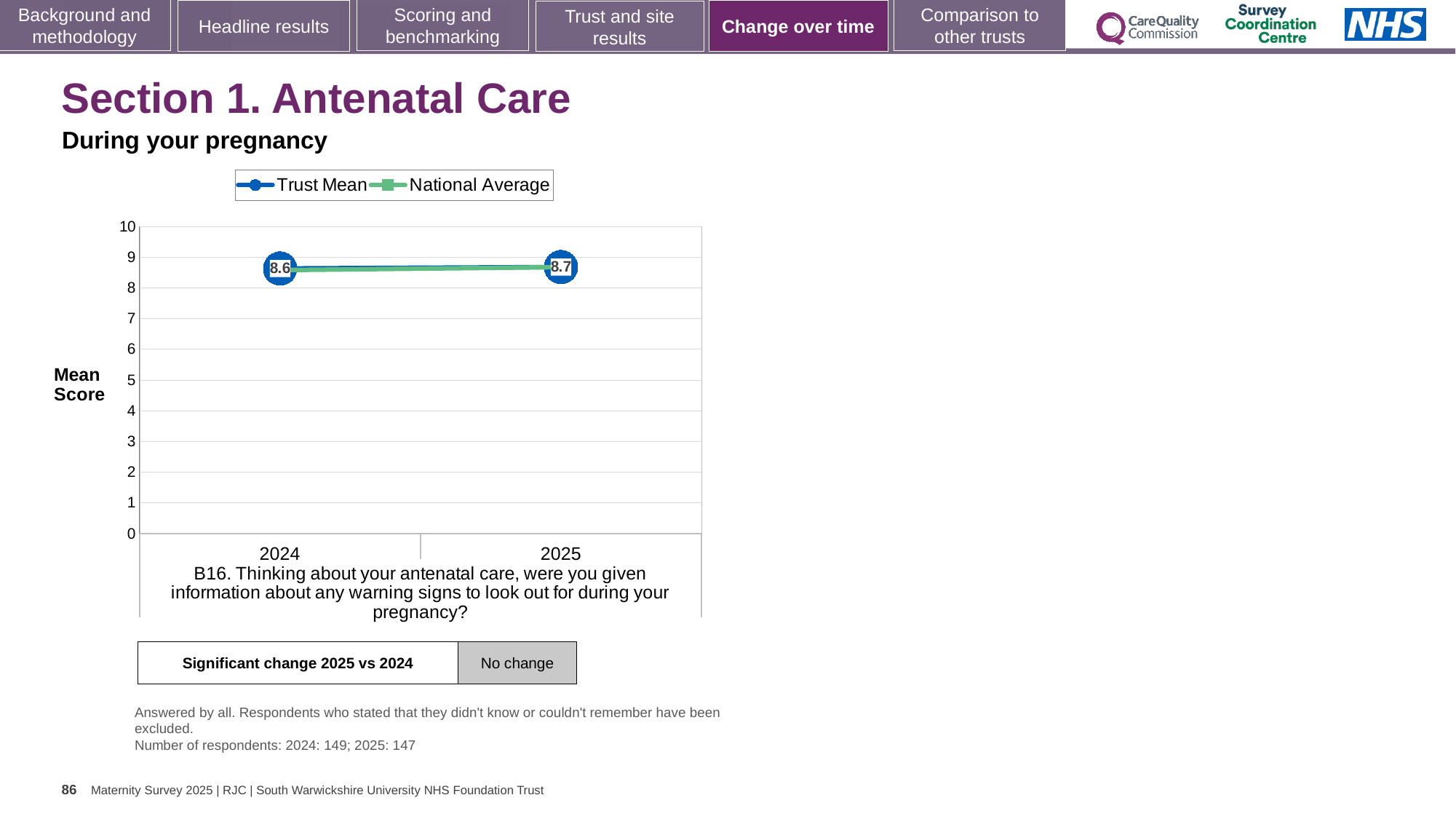
What are the two series named in the legend? Trust Mean and National Average Is the Trust Mean value for 2024 greater or less than 5? greater What is the Trust Mean value for 2025? 8.7 What is the Trust Mean value for 2024? 8.6 What kind of chart is shown on the slide? Line chart What is the label on the y axis of the chart? Mean Score Which year has the higher Trust Mean, 2024 or 2025? 2025 How many years are plotted on the x axis? 2 What is the difference between the Trust Mean for 2025 and the Trust Mean for 2024? 0.1 Does the Trust Mean rise or fall from 2024 to 2025? Rises Is the National Average value for 2025 greater or less than 8? greater How many series does the legend list? 2